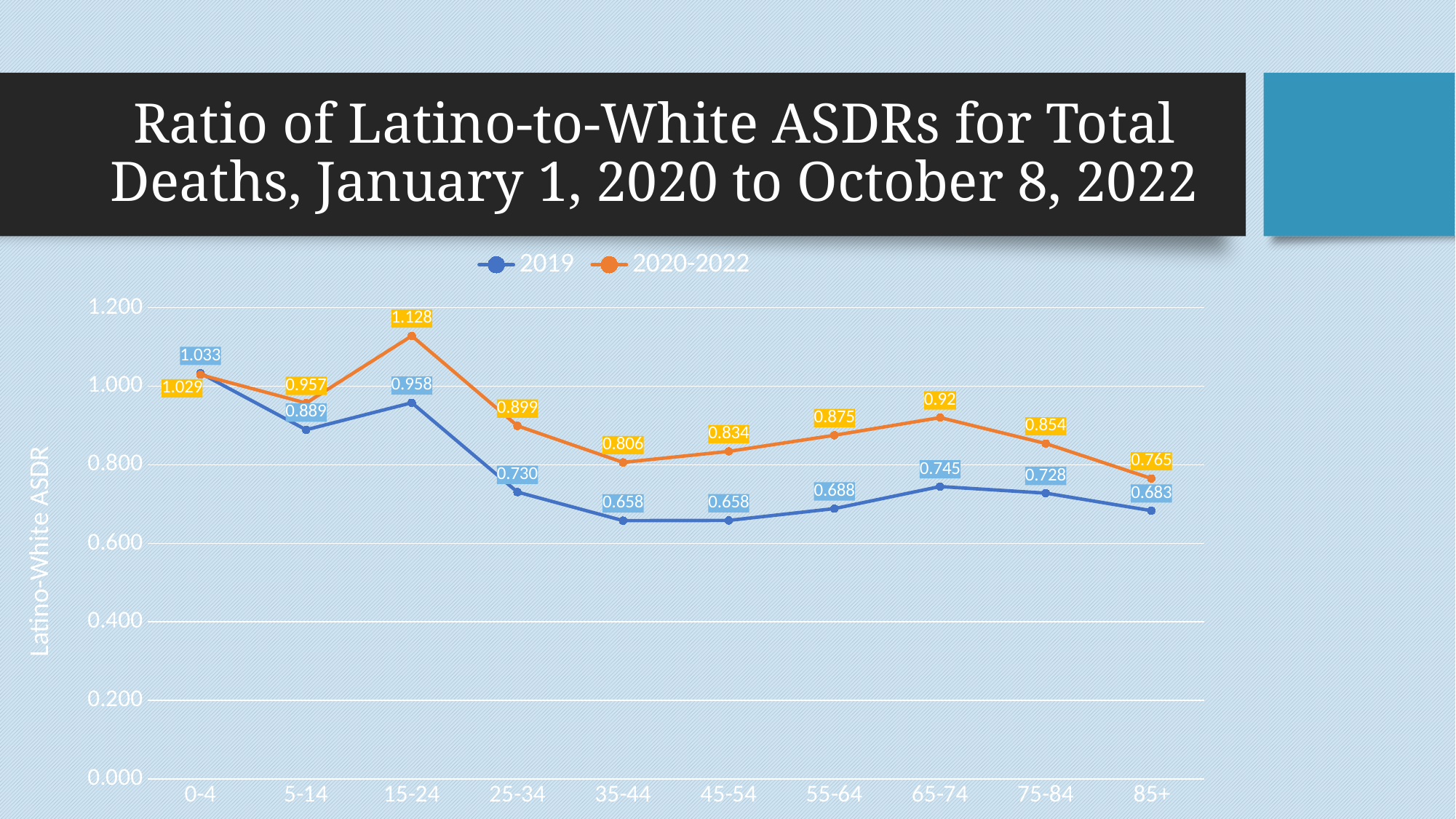
What is the 2019 ratio for the 85+ age group? 0.683 Which age group has the highest 2020-2022 ratio? 15-24 Which age group has the lowest 2020-2022 ratio? 85+ What is the difference between the 2020-2022 and 2019 ratios for the 15-24 age group? 0.170 Does the 2020-2022 ratio rise or fall from the 35-44 age group to the 65-74 age group? Rise What kind of chart is shown on the slide? Line chart How many age groups are shown on the x axis? 10 What is the difference between the 2020-2022 and 2019 ratios for the 85+ age group? 0.082 How many series does the legend list? 2 For the 0-4 age group, which series has the larger ratio, 2019 or 2020-2022? 2019 What is the 2020-2022 ratio for the 65-74 age group? 0.92 What is the 2019 ratio for the 15-24 age group? 0.958